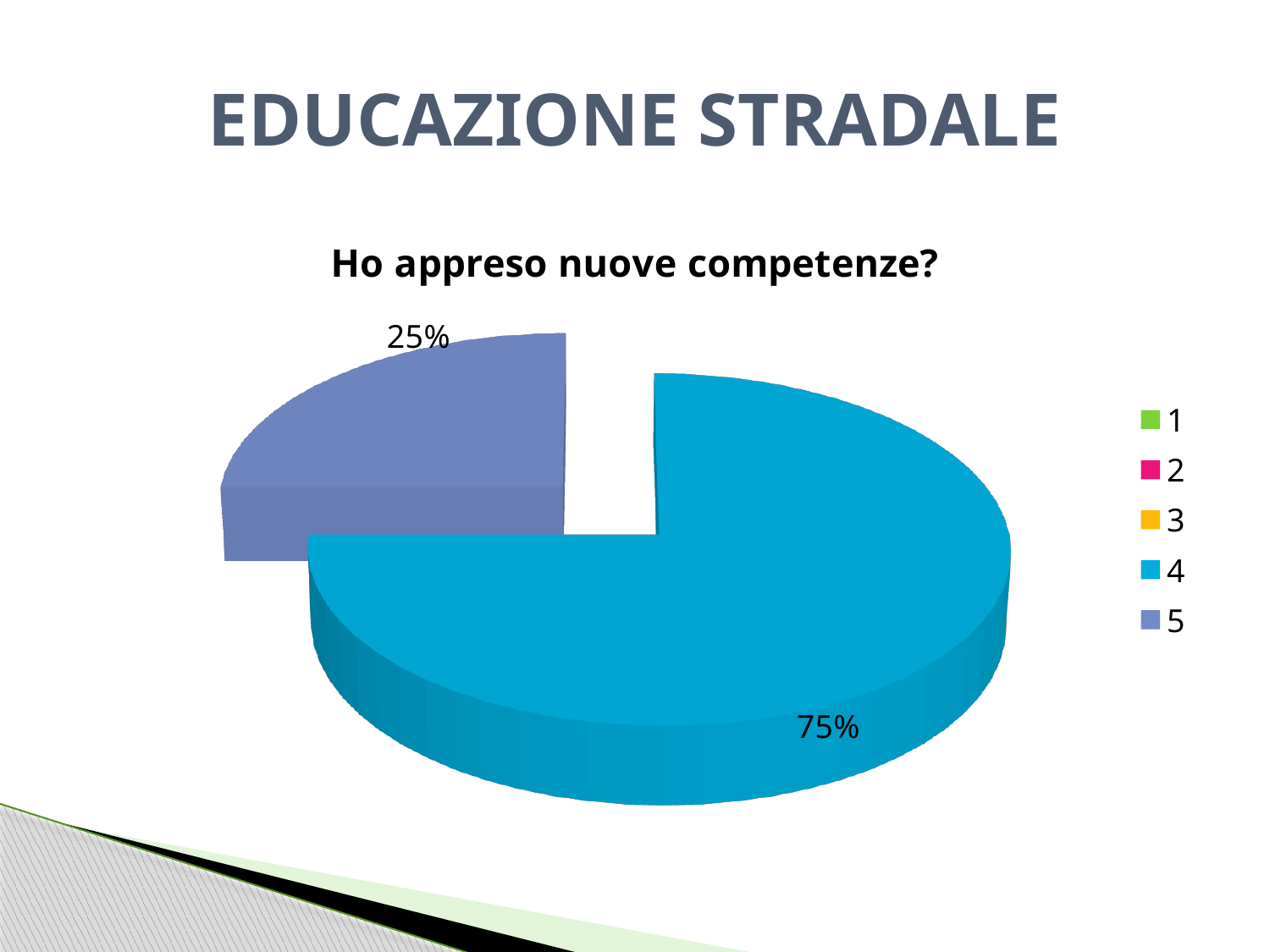
What share of the pie does category 4 represent? 75% How many slices are visible in the pie? 2 What is the title of the chart? Ho appreso nuove competenze? Which of the visible slices is smaller, category 4 or category 5? 5 How many entries does the legend list? 5 What is the difference between the shares of category 4 and category 5? 50% What kind of chart is shown on the slide? pie chart What colour is the slice for category 4? blue Is the share for category 5 greater or less than 50%? less Which category has the largest slice of the pie? 4 What share of the pie does category 5 represent? 25%